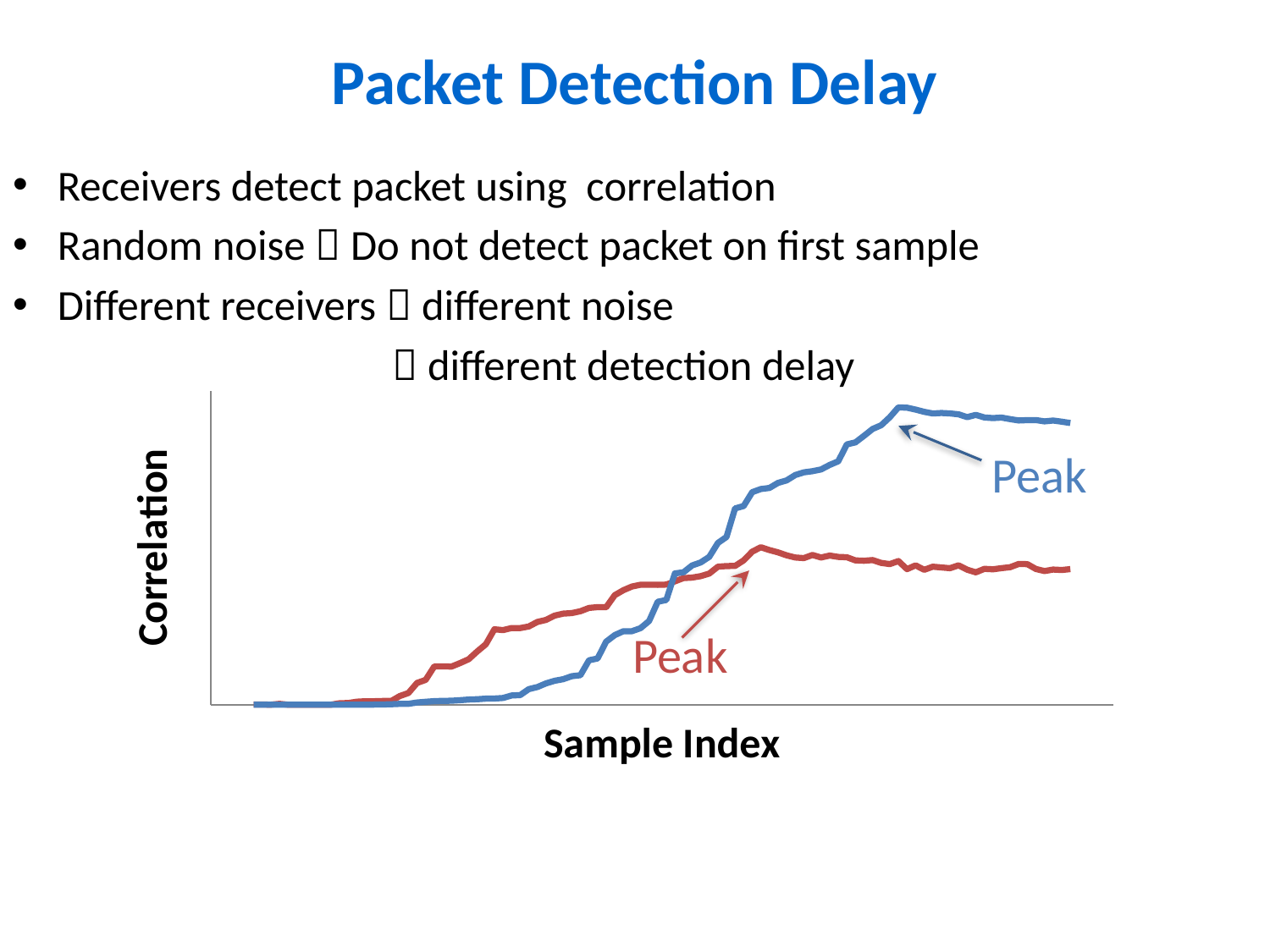
Which line reaches its peak at a larger sample index, the blue line or the red line? The blue line What is the label of the horizontal axis of the chart? Sample Index What kind of chart is shown on the slide? Line chart Which line reaches a higher peak correlation, the blue line or the red line? The blue line Do the correlation values of the blue line generally rise or fall as the sample index increases? Rise How many lines are plotted on the chart? 2 Which line starts rising earlier along the sample index axis, the blue line or the red line? The red line Do the correlation values of the red line generally rise or fall as the sample index increases? Rise What is the label of the vertical axis of the chart? Correlation